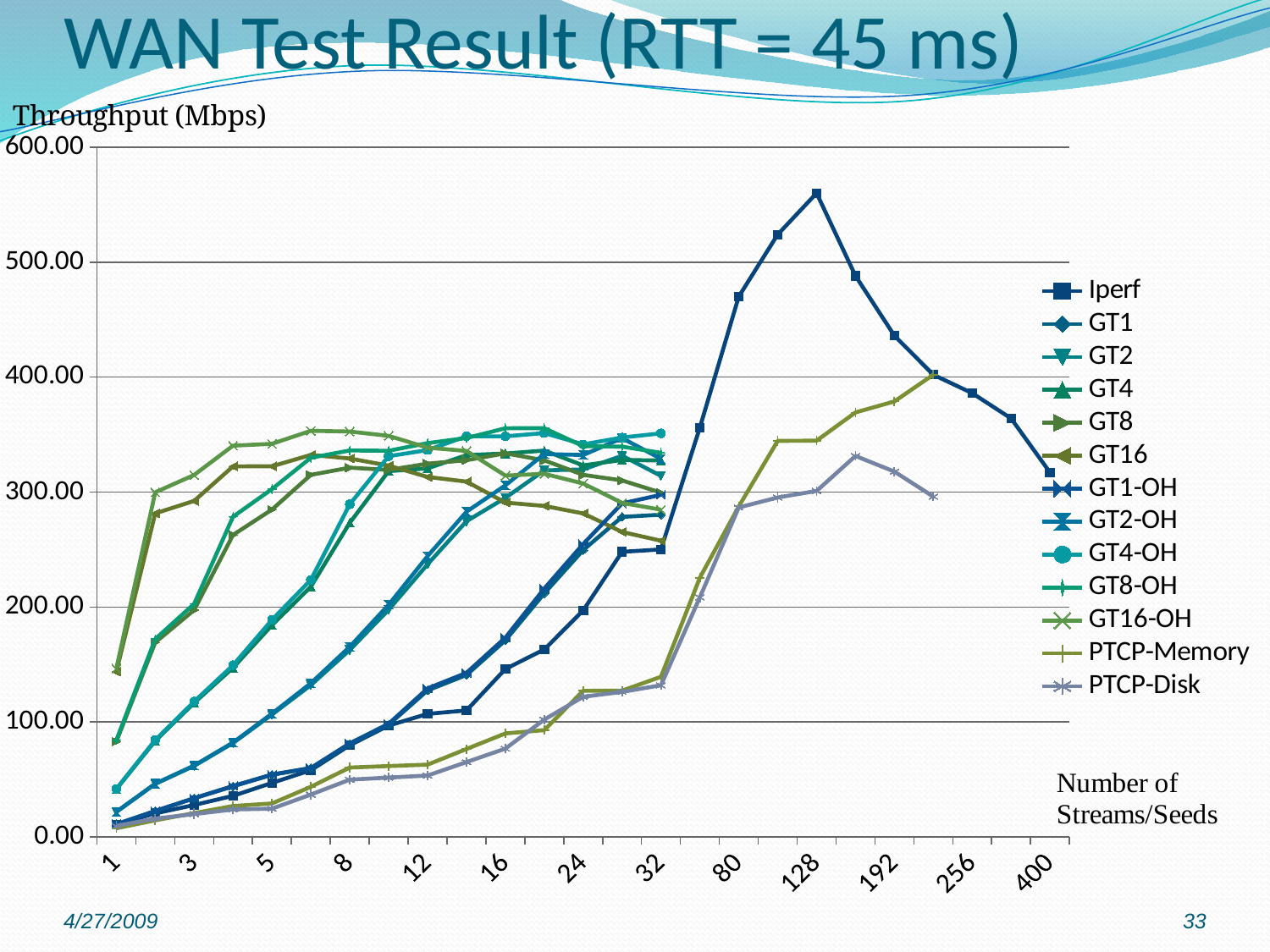
Is the peak value of the Iperf series greater or less than 500? greater At 128 streams, which series has the higher throughput, Iperf or PTCP-Memory? Iperf Does the Iperf series rise or fall between 128 and 400 streams? fall At 1 stream, which series has the higher throughput, GT16 or GT1? GT16 What quantity is plotted on the vertical axis? Throughput (Mbps) Which series reaches the highest throughput on the chart? Iperf Is the Iperf value at 400 streams greater or less than 400? less Is the PTCP-Memory value at 192 streams greater or less than 300? greater How many series does the legend list? 13 What kind of chart is shown on the slide? line chart What is the title of the chart? WAN Test Result (RTT = 45 ms)